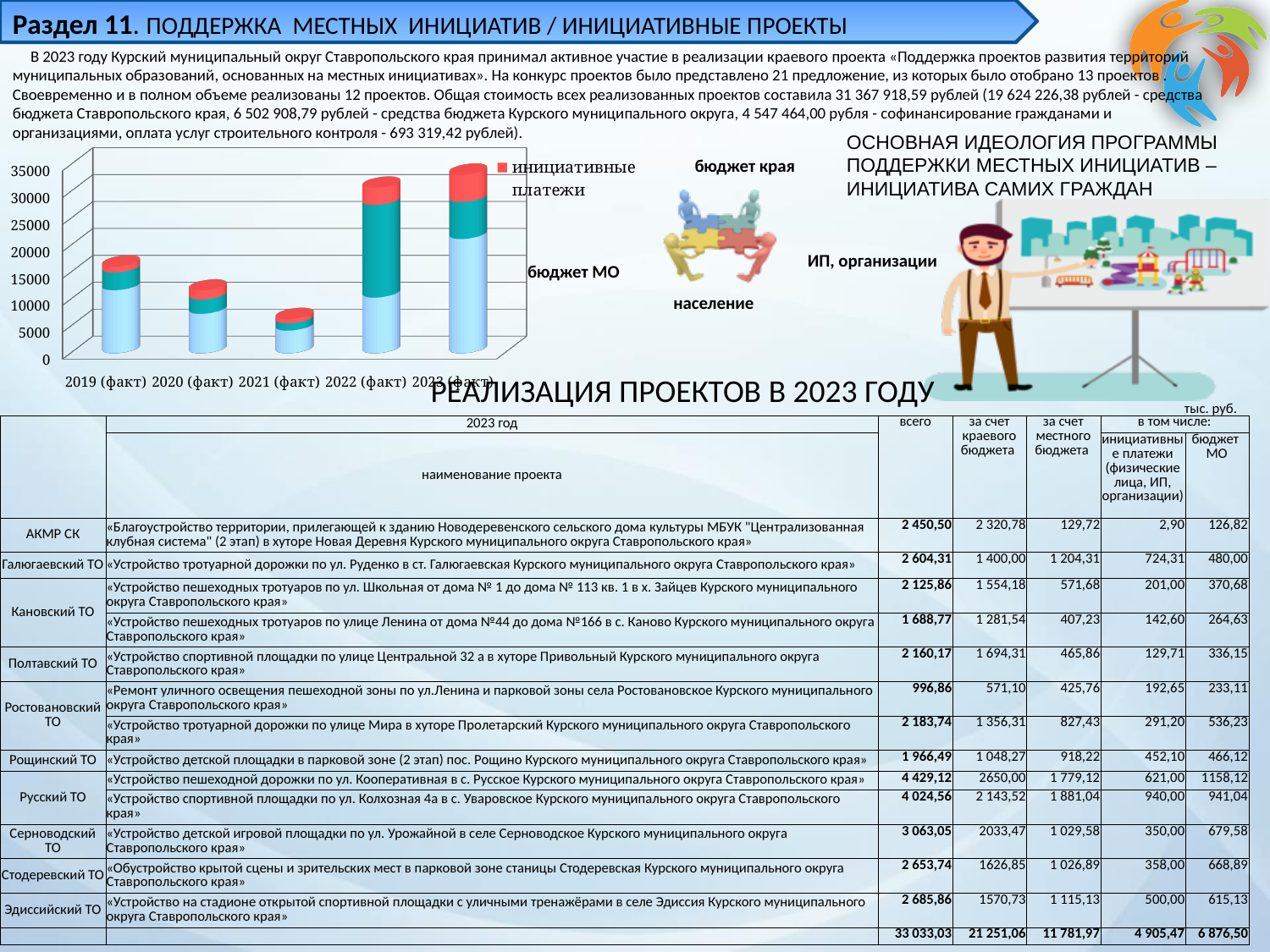
Which bar is taller, 2019 (факт) or 2020 (факт)? 2019 (факт) Do the bar totals rise or fall from 2019 (факт) to 2021 (факт)? fall What kind of chart is shown on the slide? bar chart How many categories (years) are shown on the x axis of the bar chart? 5 Is the total bar value for 2020 (факт) greater or less than 10000? greater Is the total bar value for 2019 (факт) greater or less than 15000? greater Do the bar totals rise or fall from 2021 (факт) to 2023 (факт)? rise Which year has the tallest bar in the chart? 2023 (факт) What colour represents the series 'инициативные платежи' in the chart? red Which year has the shortest bar in the chart? 2021 (факт) Is the total bar value for 2021 (факт) greater or less than 10000? less